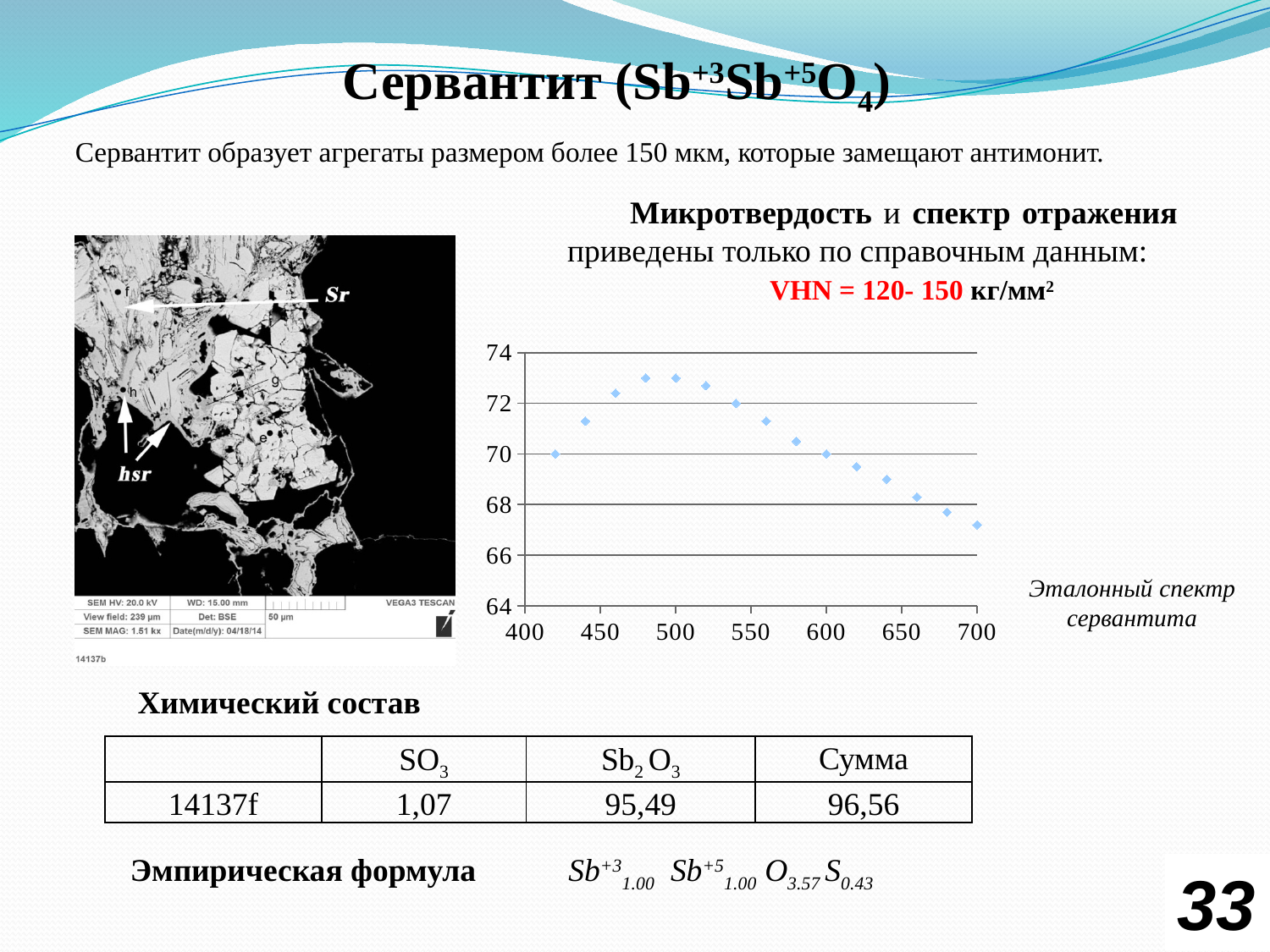
What caption is written to the right of the chart? Эталонный спектр сервантита At which x-axis value is the plotted value lowest? 700 What is the highest value shown on the chart's y axis? 74 Is the value at x = 700 greater or less than 68? less Do the plotted values rise or fall along the x axis from 500 to 700? fall How many data points are plotted on the chart? 15 Is the value at x = 440 greater or less than 70? greater Is the value at x = 620 greater or less than 70? less What kind of chart is shown on the slide? scatter chart Which has the larger value: the point at x = 460 or the point at x = 640? 460